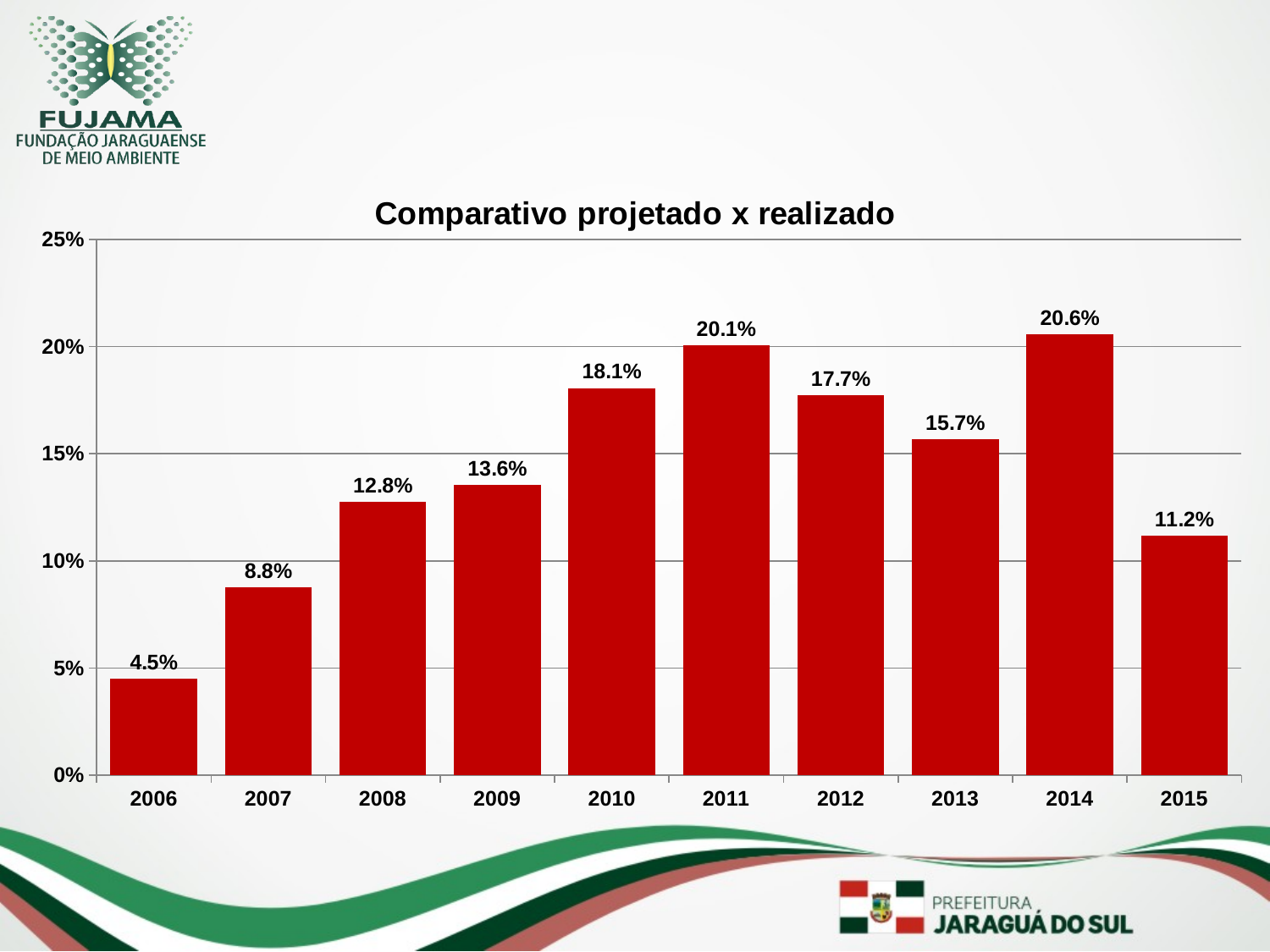
What is the value for 2010? 18.1% Which year has the lowest value? 2006 What is the value for 2015? 11.2% What kind of chart is shown on the slide? bar chart How many years are shown on the x axis? 10 What is the title of the chart? Comparativo projetado x realizado Which year has the highest value? 2014 What is the difference between the values for 2011 and 2012? 2.4% Which is larger, the value for 2008 or the value for 2013? 2013 What is the value for 2006? 4.5% What is the difference between the values for 2014 and 2015? 9.4% Is the value for 2009 greater or less than 15%? less